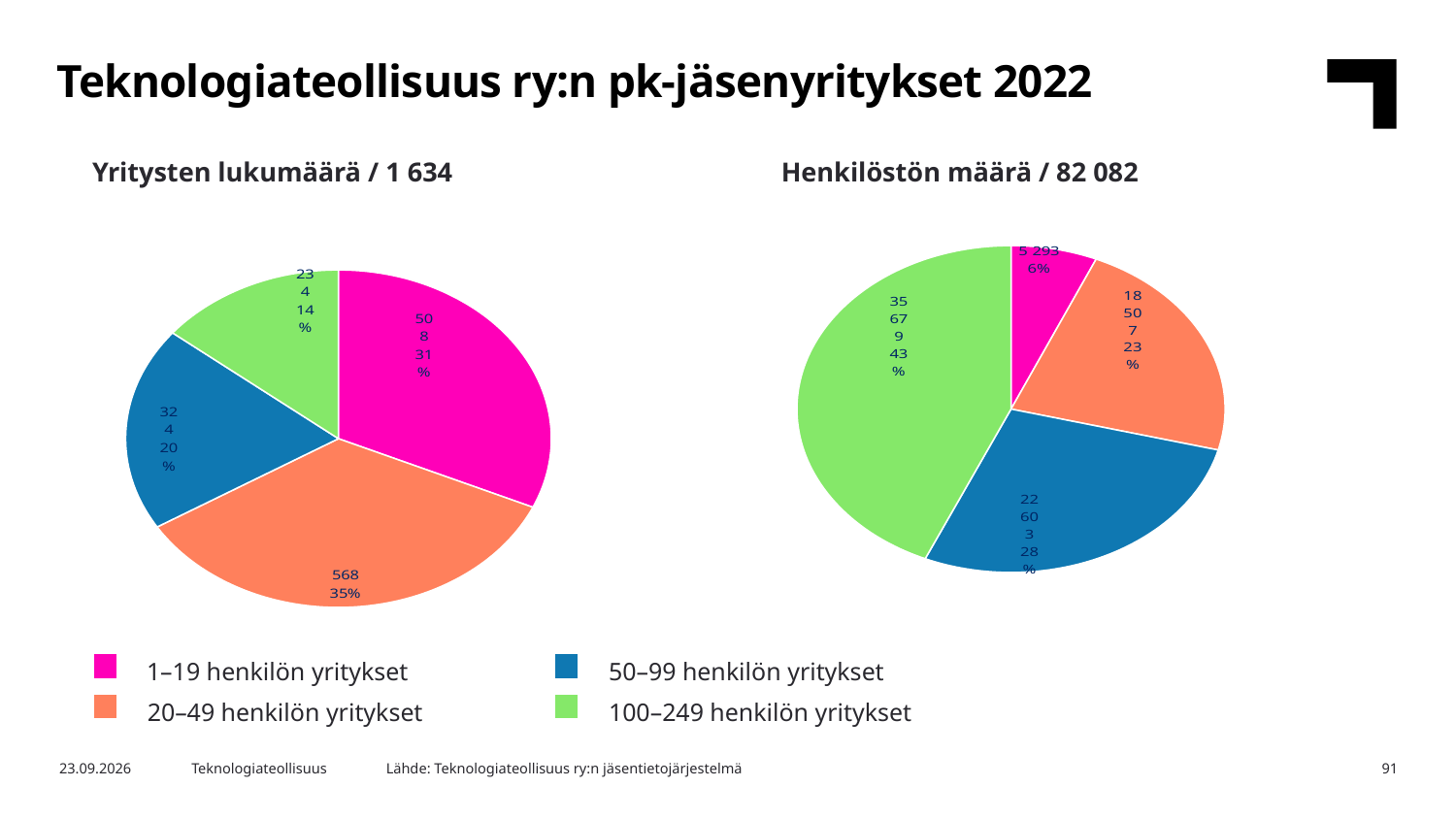
In the 'Yritysten lukumäärä / 1 634' chart, which category has the largest slice? 20–49 henkilön yritykset In the 'Yritysten lukumäärä / 1 634' chart, which category has the smallest slice? 100–249 henkilön yritykset In the 'Henkilöstön määrä / 82 082' chart, which category has the largest slice? 100–249 henkilön yritykset In the 'Yritysten lukumäärä / 1 634' chart, what share of the pie do 20–49 henkilön yritykset have? 35% How many categories does the legend list? 4 Which colour represents 50–99 henkilön yritykset in the charts? Blue In the 'Henkilöstön määrä / 82 082' chart, which is larger: the slice for 50–99 henkilön yritykset or the slice for 20–49 henkilön yritykset? 50–99 henkilön yritykset In the 'Henkilöstön määrä / 82 082' chart, what is the value for 1–19 henkilön yritykset? 5 293 In the 'Yritysten lukumäärä / 1 634' chart, what share of the pie do 1–19 henkilön yritykset have? 31% In the 'Henkilöstön määrä / 82 082' chart, what share of the pie do 100–249 henkilön yritykset have? 43% What type of charts are shown on the slide? Pie charts In the 'Yritysten lukumäärä / 1 634' chart, what is the value for 20–49 henkilön yritykset? 568